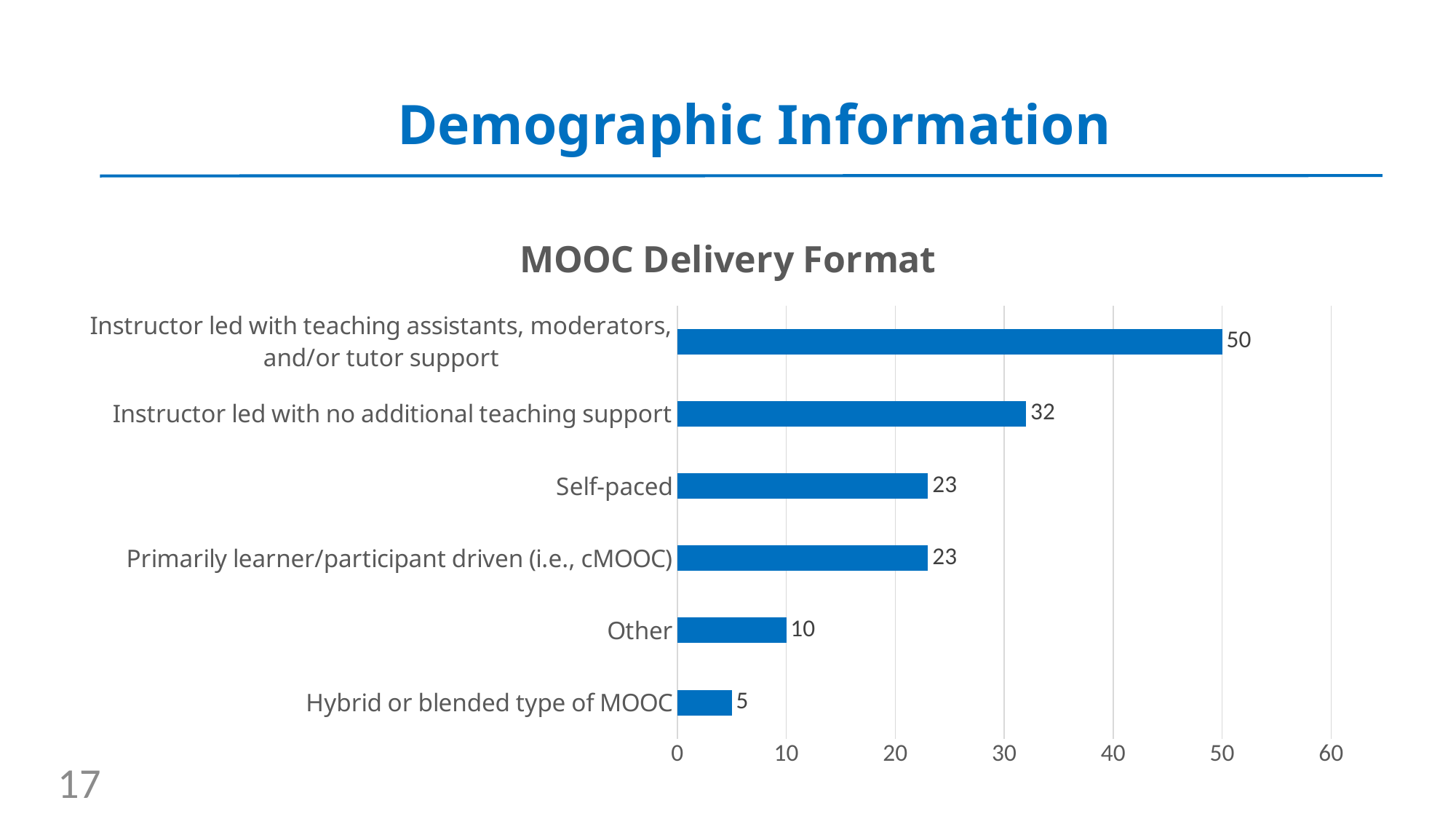
Which delivery format has the highest value? Instructor led with teaching assistants, moderators, and/or tutor support What is the value for Self-paced in the MOOC Delivery Format chart? 23 What is the difference between the value for Instructor led with teaching assistants, moderators, and/or tutor support and the value for Instructor led with no additional teaching support? 18 How many delivery format categories are shown in the chart? 6 What is the value for Other in the MOOC Delivery Format chart? 10 Which delivery format has the lowest value? Hybrid or blended type of MOOC What is the value for Hybrid or blended type of MOOC? 5 Which is larger: the value for Other or the value for Hybrid or blended type of MOOC? Other Is the value for Instructor led with no additional teaching support greater or less than 30? greater What kind of chart is shown on the slide? Bar chart What is the value for Instructor led with no additional teaching support? 32 What is the title of the chart on the slide? MOOC Delivery Format